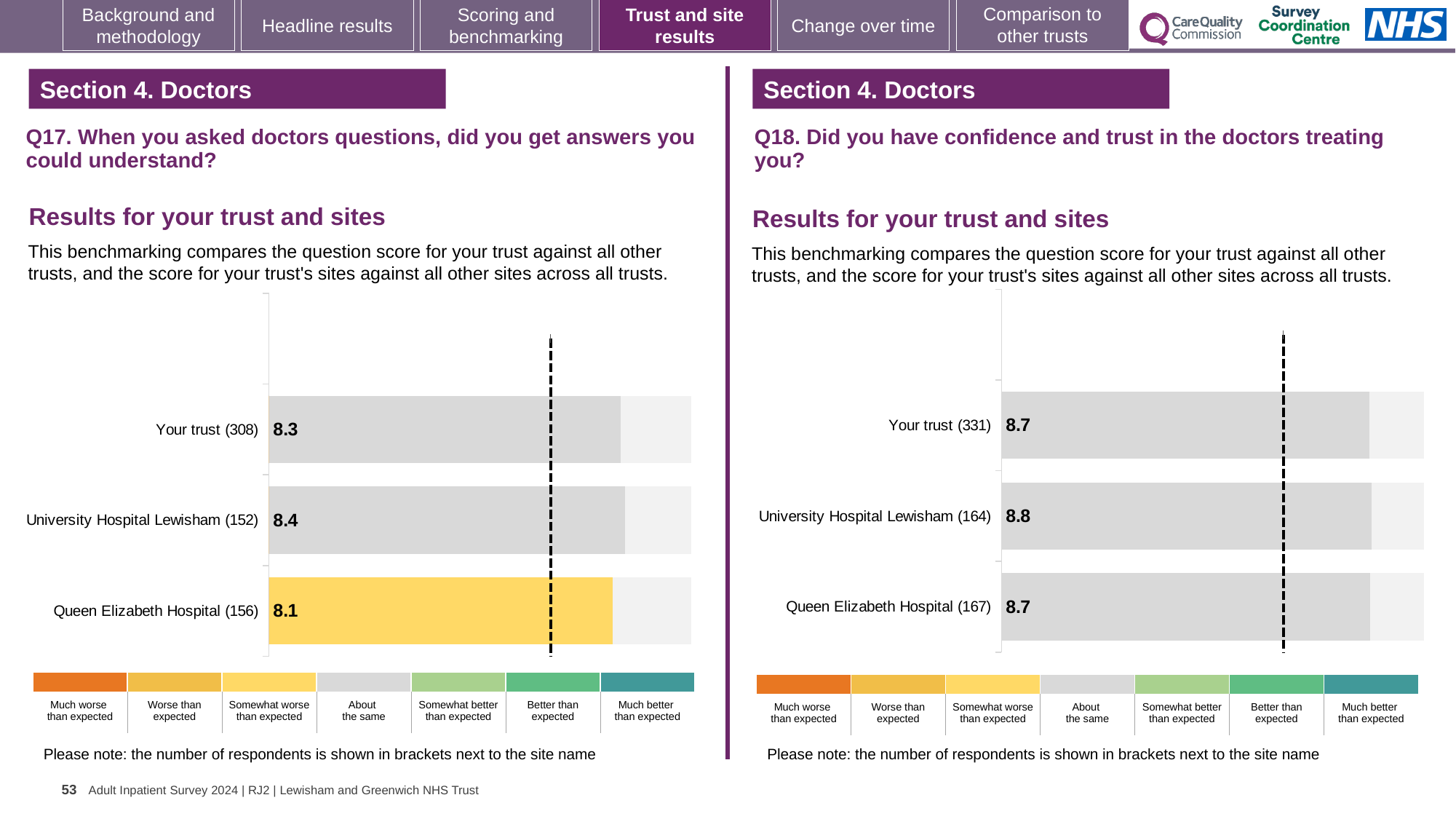
In the Q18 chart on the right, what is the score for Queen Elizabeth Hospital (167)? 8.7 In the Q17 chart on the left, which site or trust has the lowest score? Queen Elizabeth Hospital (156) In the Q18 chart on the right, what is the score for University Hospital Lewisham (164)? 8.8 In the Q18 chart on the right, what is the difference between the scores for University Hospital Lewisham and Your trust? 0.1 In the Q17 chart on the left, what is the score for Queen Elizabeth Hospital (156)? 8.1 In the Q17 chart on the left, what is the difference between the scores for University Hospital Lewisham and Queen Elizabeth Hospital? 0.3 In the Q17 chart on the left, what is the score for Your trust (308)? 8.3 In the Q17 chart on the left, how many bars are plotted? 3 What kind of chart is used in the Q18 chart on the right? Bar chart In the Q17 chart on the left, which site or trust has the highest score? University Hospital Lewisham (152) In the Q17 chart on the left, which bar is coloured yellow rather than grey? Queen Elizabeth Hospital (156) In the Q18 chart on the right, which site or trust has the highest score? University Hospital Lewisham (164)